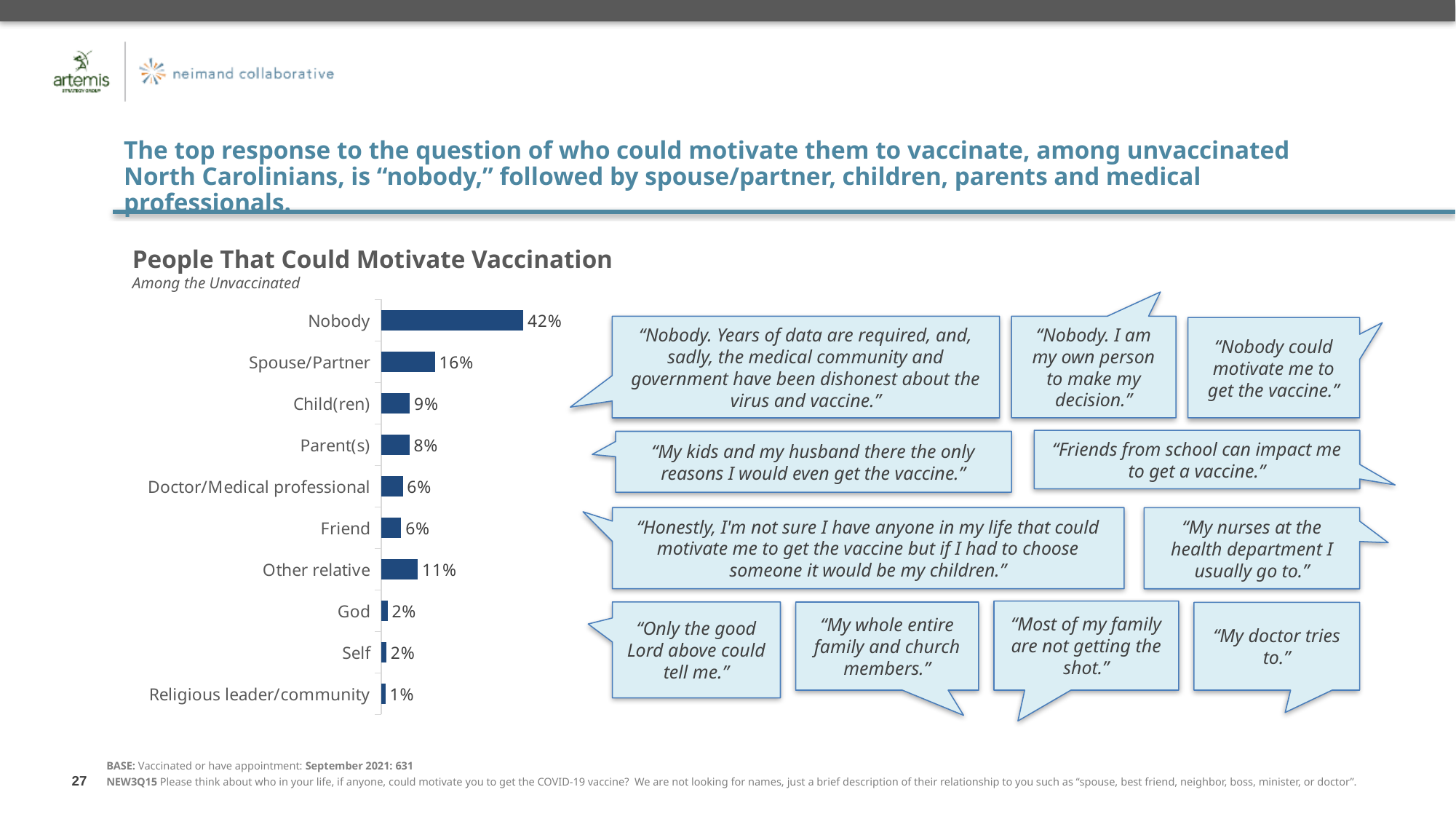
Which category has the highest value in the chart? Nobody What is the difference between the values for Nobody and Spouse/Partner? 26 percentage points What percentage of unvaccinated respondents said "Nobody" could motivate them to vaccinate? 42% Which category has the lowest value in the chart? Religious leader/community What kind of chart is shown on the slide? Bar chart What is the title of the chart? People That Could Motivate Vaccination What is the difference between the values for Child(ren) and Parent(s)? 1 percentage point What is the value for Spouse/Partner in the chart? 16% How many categories are shown in the chart? 10 Which is larger, the value for Child(ren) or the value for Other relative? Other relative What is the value for Doctor/Medical professional? 6% What is the value for Other relative? 11%